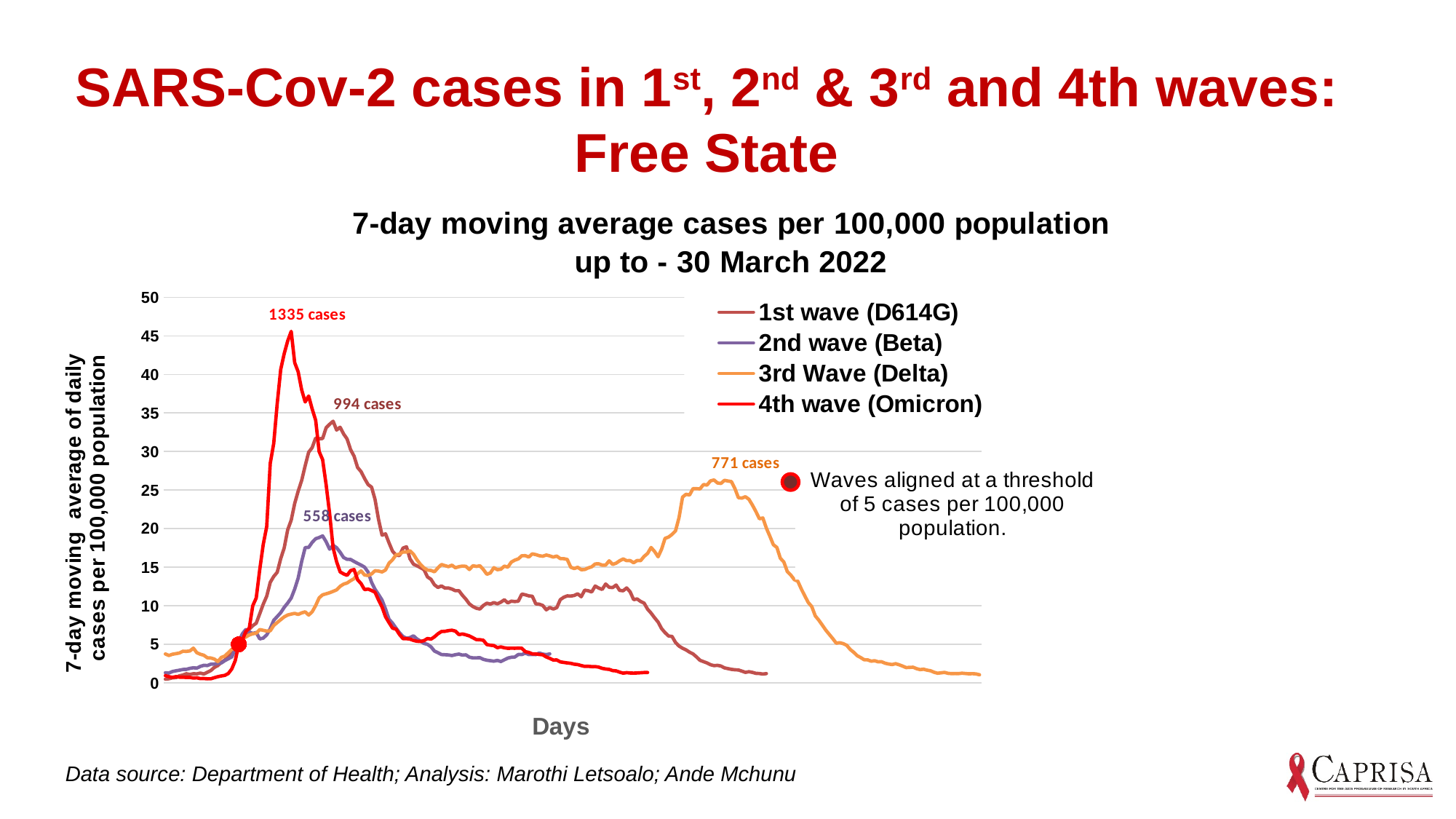
What is the peak case count annotated for the 4th wave (Omicron)? 1335 cases What is the label of the x axis? Days What is the peak case count annotated for the 1st wave (D614G)? 994 cases What is the difference between the annotated peak case counts of the 4th wave (Omicron) and the 1st wave (D614G)? 341 cases Which wave has the lowest annotated peak case count? 2nd wave (Beta) Which wave has the highest annotated peak case count? 4th wave (Omicron) Is the peak of the 4th wave (Omicron) line greater or less than 40 cases per 100,000 population? greater Is the peak of the 2nd wave (Beta) line greater or less than 20 cases per 100,000 population? less What is the peak case count annotated for the 3rd Wave (Delta)? 771 cases What kind of chart is shown on the slide? line chart What is the peak case count annotated for the 2nd wave (Beta)? 558 cases How many series does the legend list? 4